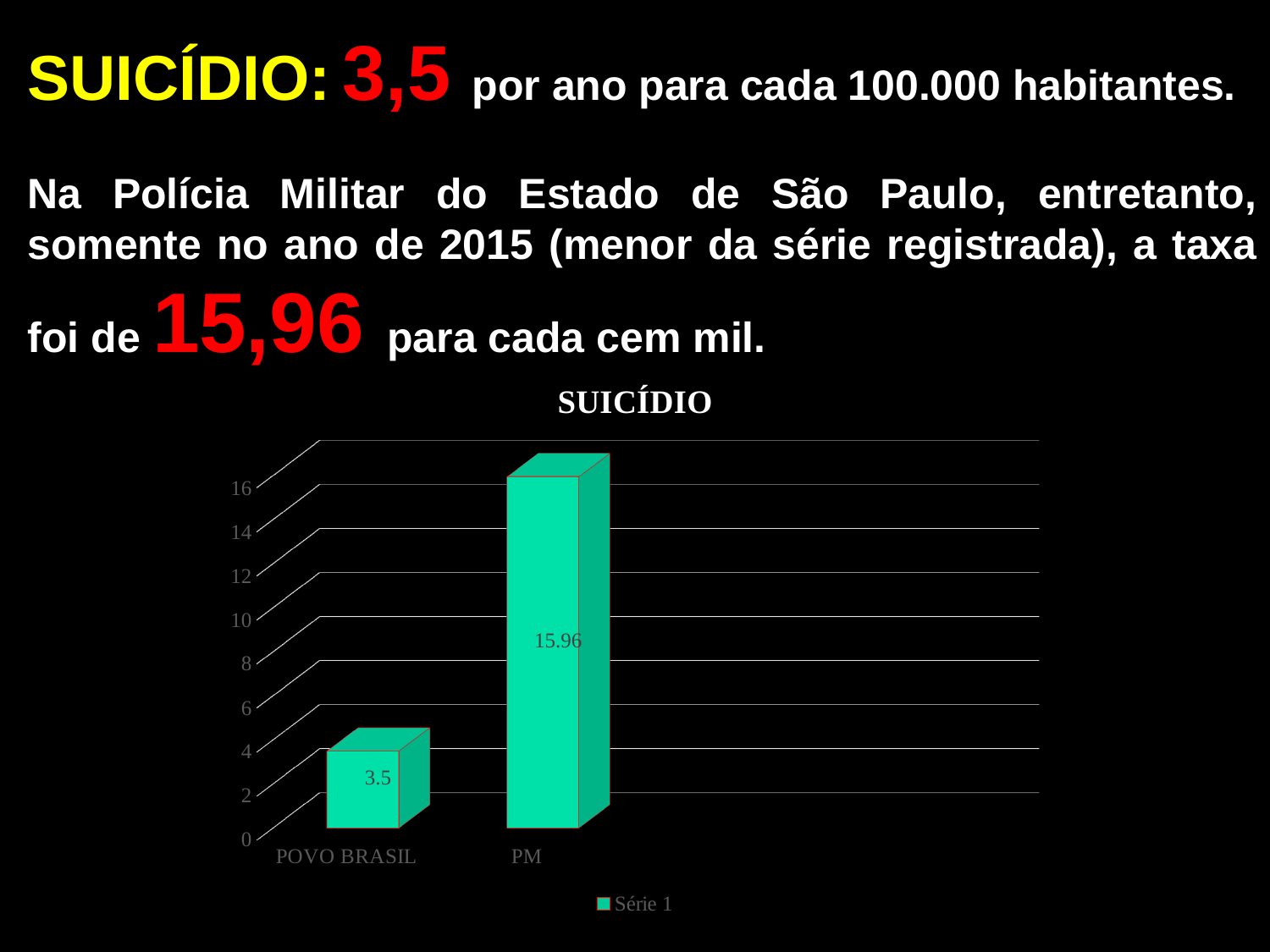
Which is larger in the SUICÍDIO chart, the value for PM or the value for POVO BRASIL? PM What is the value for PM in the SUICÍDIO chart? 15.96 How many series does the legend of the SUICÍDIO chart list? 1 Is the value for PM in the SUICÍDIO chart greater or less than 10? greater Which category has the highest value in the SUICÍDIO chart? PM What is the value for POVO BRASIL in the SUICÍDIO chart? 3.5 Is the value for POVO BRASIL in the SUICÍDIO chart greater or less than 6? less Which category has the lowest value in the SUICÍDIO chart? POVO BRASIL How many categories are shown in the SUICÍDIO chart? 2 What kind of chart is the SUICÍDIO chart? Bar chart What is the difference between the PM value and the POVO BRASIL value in the SUICÍDIO chart? 12.46 What is the name of the series shown in the legend of the SUICÍDIO chart? Série 1